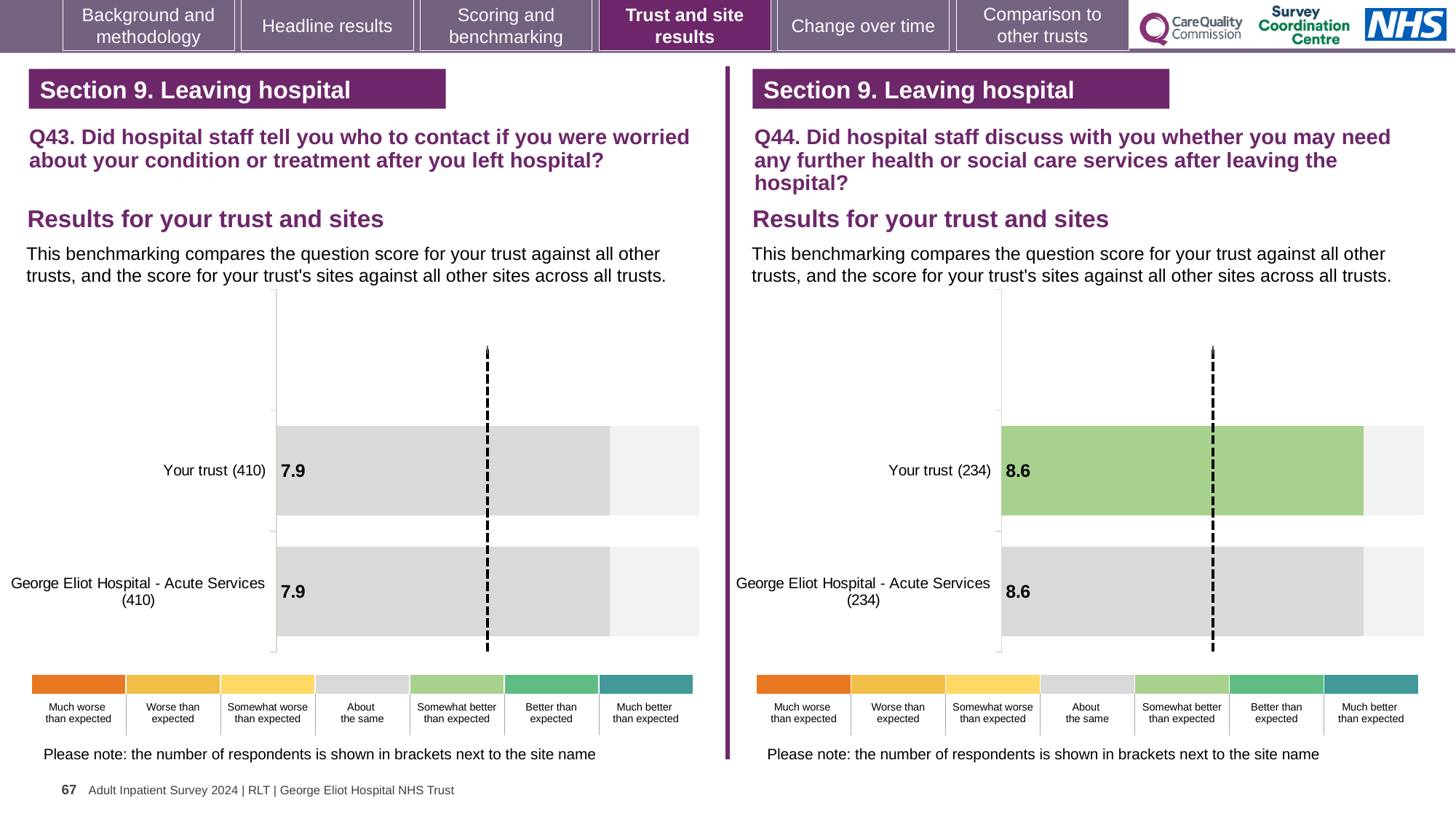
On the Q44 chart (right), what is the score for Your trust (234)? 8.6 On the Q43 chart (left), what is the difference between the score for Your trust and the score for George Eliot Hospital - Acute Services? 0 On the Q44 chart (right), which benchmark category does the colour of the Your trust bar correspond to according to the legend? Somewhat better than expected On the Q43 chart (left), which benchmark category does the colour of the Your trust bar correspond to according to the legend? About the same On the Q43 chart (left), what is the score for Your trust (410)? 7.9 How many respondents are shown in brackets for Your trust on the Q44 chart (right)? 234 How many bars are plotted on the Q43 chart (left)? 2 How many bars are plotted on the Q44 chart (right)? 2 On the Q44 chart (right), what is the difference between the score for Your trust and the score for George Eliot Hospital - Acute Services? 0 On the Q43 chart (left), what is the score for George Eliot Hospital - Acute Services (410)? 7.9 On the Q44 chart (right), what is the score for George Eliot Hospital - Acute Services (234)? 8.6 What kind of chart is used on the Q43 chart (left)? Bar chart